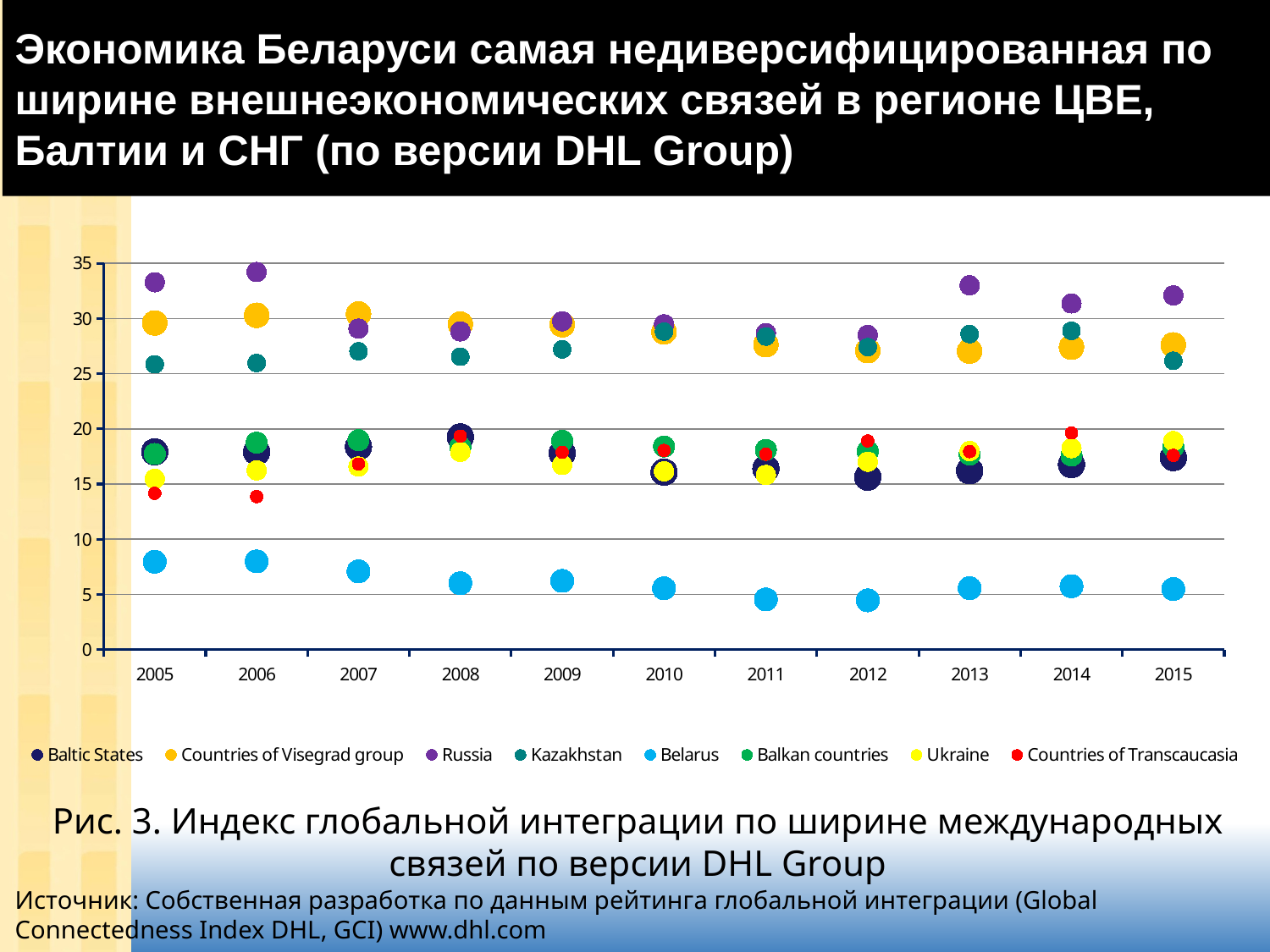
Is the value for Russia in 2013 greater or less than 30? greater Which series has the highest value in 2006? Russia How many series does the legend list? 8 Is the value for Belarus in 2005 greater or less than 10? less Which series has the lowest values across all years? Belarus Which is larger for Belarus, the value in 2005 or the value in 2015? 2005 Is the value for Baltic States in 2012 greater or less than 20? less What kind of chart is shown on the slide? scatter (bubble) chart How many years are shown on the x axis? 11 Which is larger in 2015, the value for Russia or the value for Kazakhstan? Russia Which series is shown in light blue in the legend? Belarus